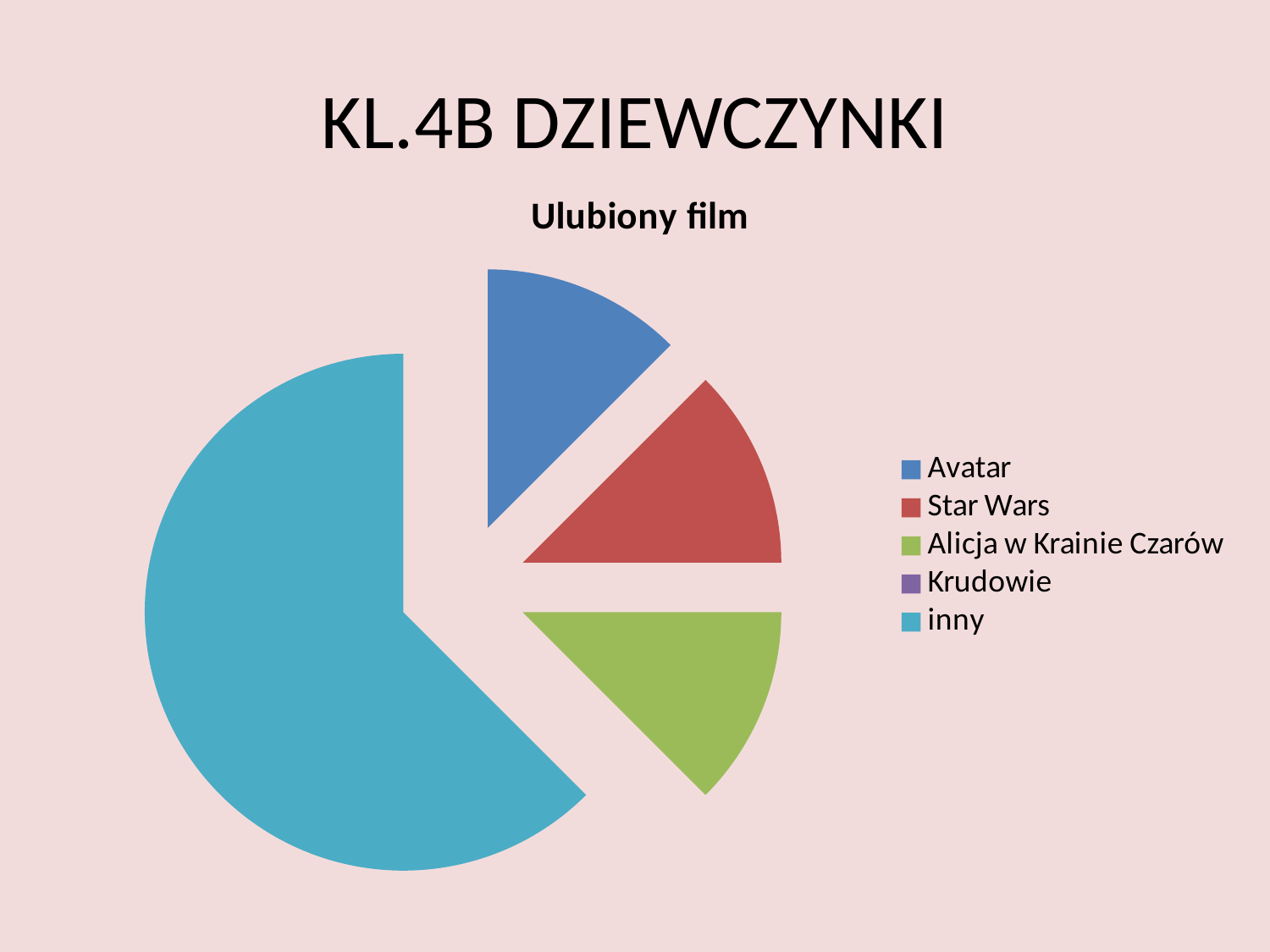
Is the inny slice larger or smaller than all the other slices combined? larger How many entries does the chart's legend list? 5 What is the title of the chart? Ulubiony film Which slice is larger, inny or Avatar? inny Which film has the largest slice of the pie? inny Which colour represents Star Wars in the pie chart? red Which slice is larger, inny or Star Wars? inny What kind of chart is shown on the slide? pie chart